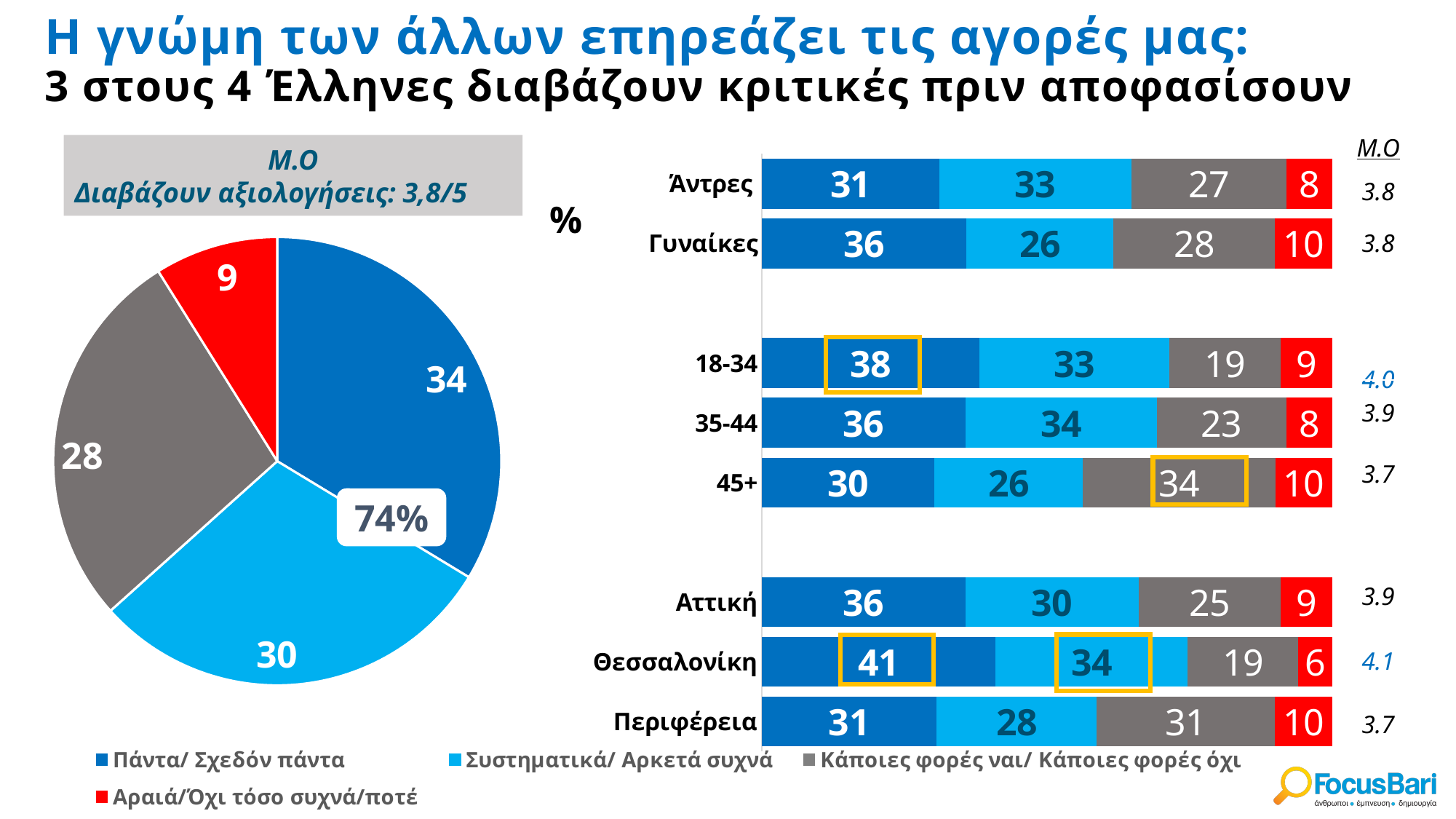
In the stacked bar chart on the right, what is the 'Κάποιες φορές ναι/ Κάποιες φορές όχι' value for 45+? 34 In the pie chart on the left, what is the value of the 'Πάντα/ Σχεδόν πάντα' (dark blue) slice? 34 In the stacked bar chart on the right, is the 'Πάντα/ Σχεδόν πάντα' value larger for Γυναίκες or for Άντρες? Γυναίκες In the pie chart on the left, what is the difference between the 'Πάντα/ Σχεδόν πάντα' slice and the 'Αραιά/Όχι τόσο συχνά/ποτέ' slice? 25 In the stacked bar chart on the right, what is the 'Πάντα/ Σχεδόν πάντα' value for Θεσσαλονίκη? 41 How many categories (bars) are shown in the stacked bar chart on the right? 8 In the stacked bar chart on the right, which category has the highest 'Πάντα/ Σχεδόν πάντα' value? Θεσσαλονίκη How many series does the legend at the bottom of the slide list? 4 How many slices does the pie chart on the left have? 4 In the pie chart on the left, which category has the smallest slice? Αραιά/Όχι τόσο συχνά/ποτέ What type of chart is shown on the right side of the slide? Stacked bar chart In the stacked bar chart on the right, which category has the lowest 'Αραιά/Όχι τόσο συχνά/ποτέ' value? Θεσσαλονίκη